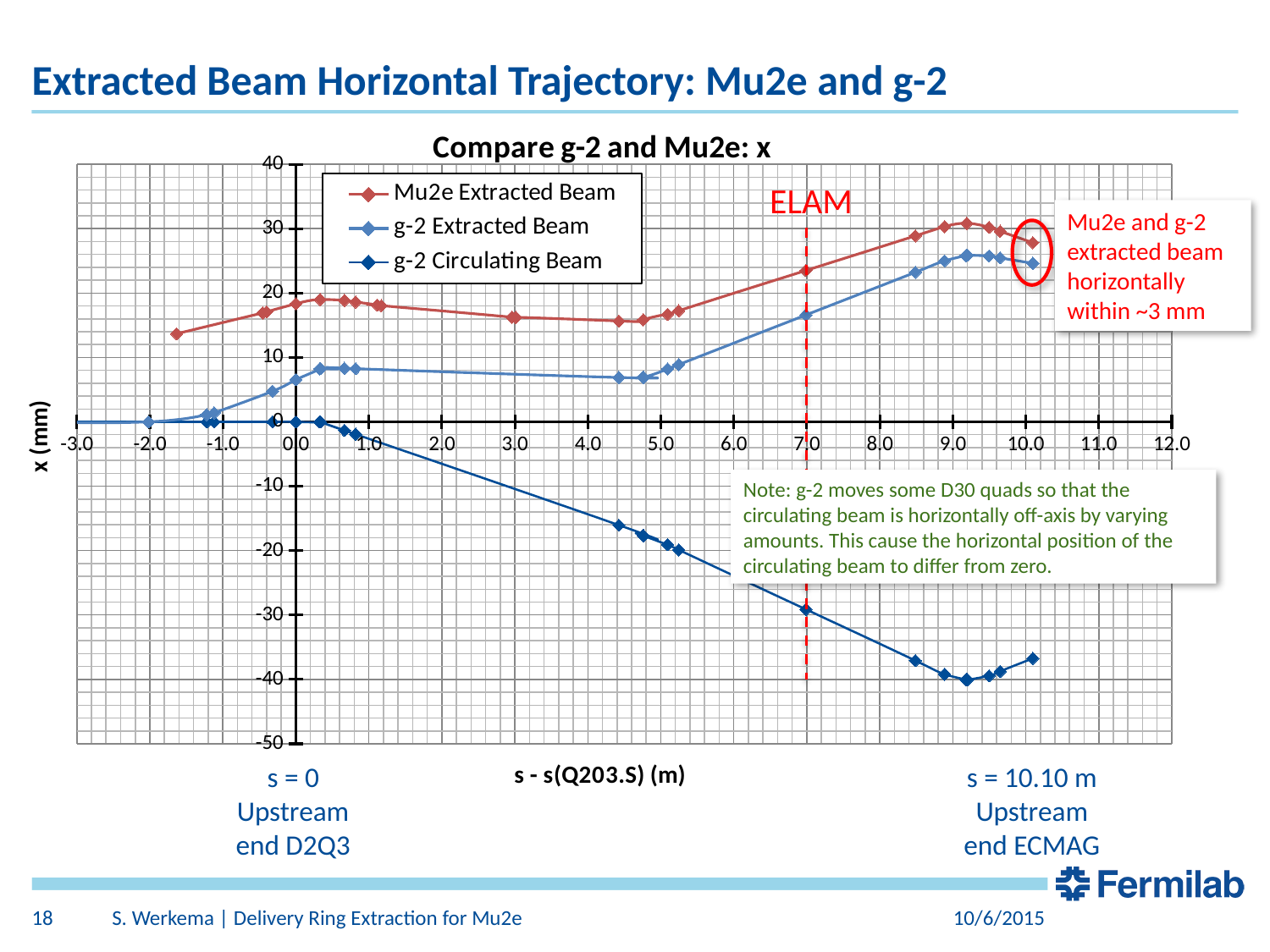
What is the title of the chart? Compare g-2 and Mu2e: x Is the value of the Mu2e Extracted Beam at s = 7.0 greater or less than 20? greater How many series does the chart legend list? 3 Does the Mu2e Extracted Beam rise or fall between s = 5.0 and s = 9.0? rise At s = 7.0, which series has the larger value: Mu2e Extracted Beam or g-2 Extracted Beam? Mu2e Extracted Beam What is the label of the x axis of the chart? s - s(Q203.S) (m) What kind of chart is shown on the slide? line chart Which series has the lowest values on the chart? g-2 Circulating Beam Does the g-2 Circulating Beam rise or fall between s = 0 and s = 9.0? fall Is the value of the g-2 Extracted Beam at s = 7.0 greater or less than 20? less Is the value of the g-2 Extracted Beam at s = 9.2 greater or less than 20? greater